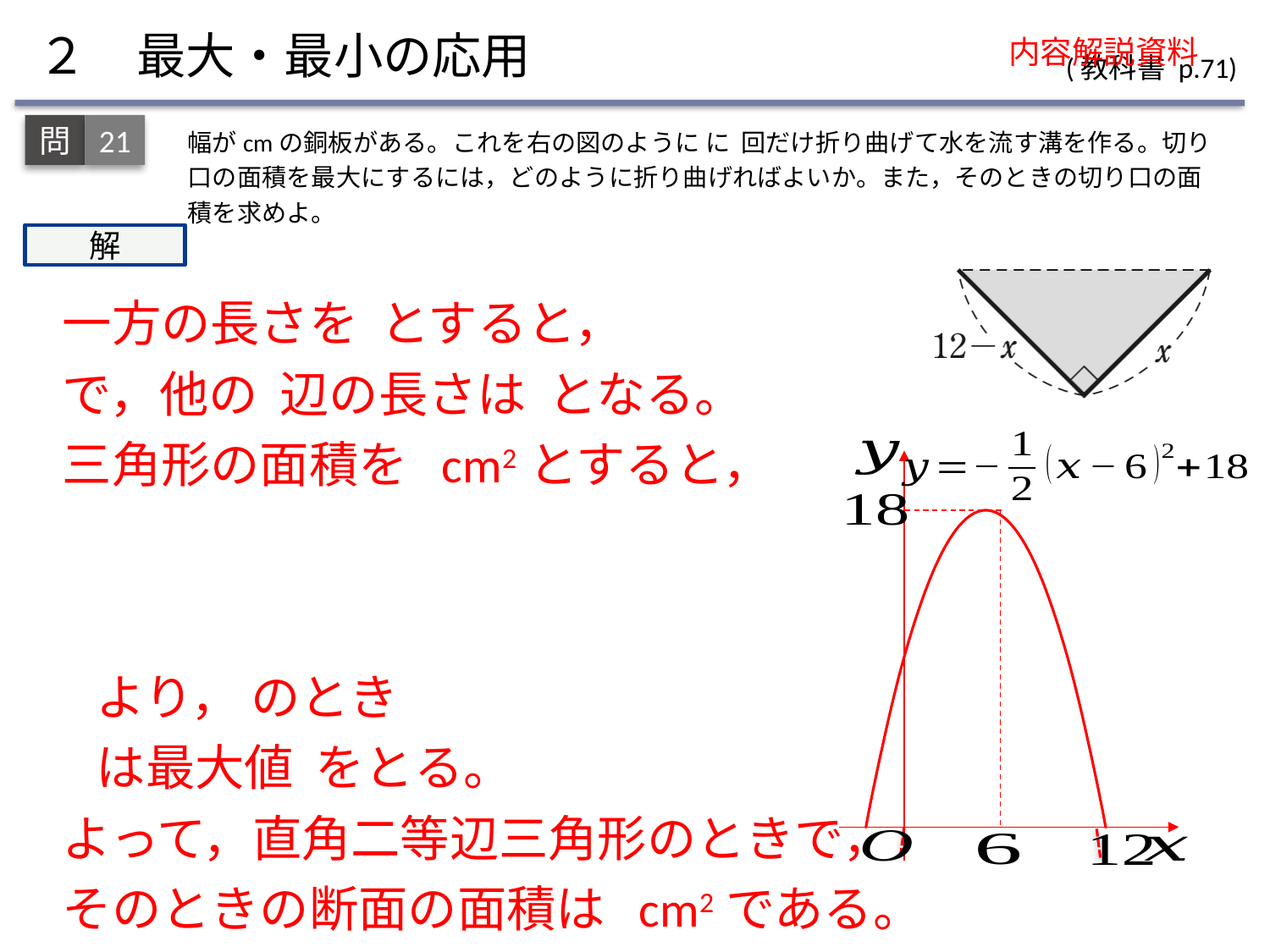
What is the maximum value of y shown on the graph? 18 What colour is the curve drawn in? red Does the curve rise or fall as x goes from 0 to 6? rises What equation is written next to the curve? y = -1/2(x-6)^2 + 18 At which x value does the curve reach its maximum? 6 At which labeled x value on the right does the curve return to the x axis? 12 Does the curve rise or fall as x goes from 6 to 12? falls What is the difference between the maximum y value and the y value at x = 12? 18 How many x-axis tick labels are shown on the graph? 3 What is the value of y at x = 6 on the graph? 18 Which is larger, the value of y at x = 6 or the value of y at x = 12? x = 6